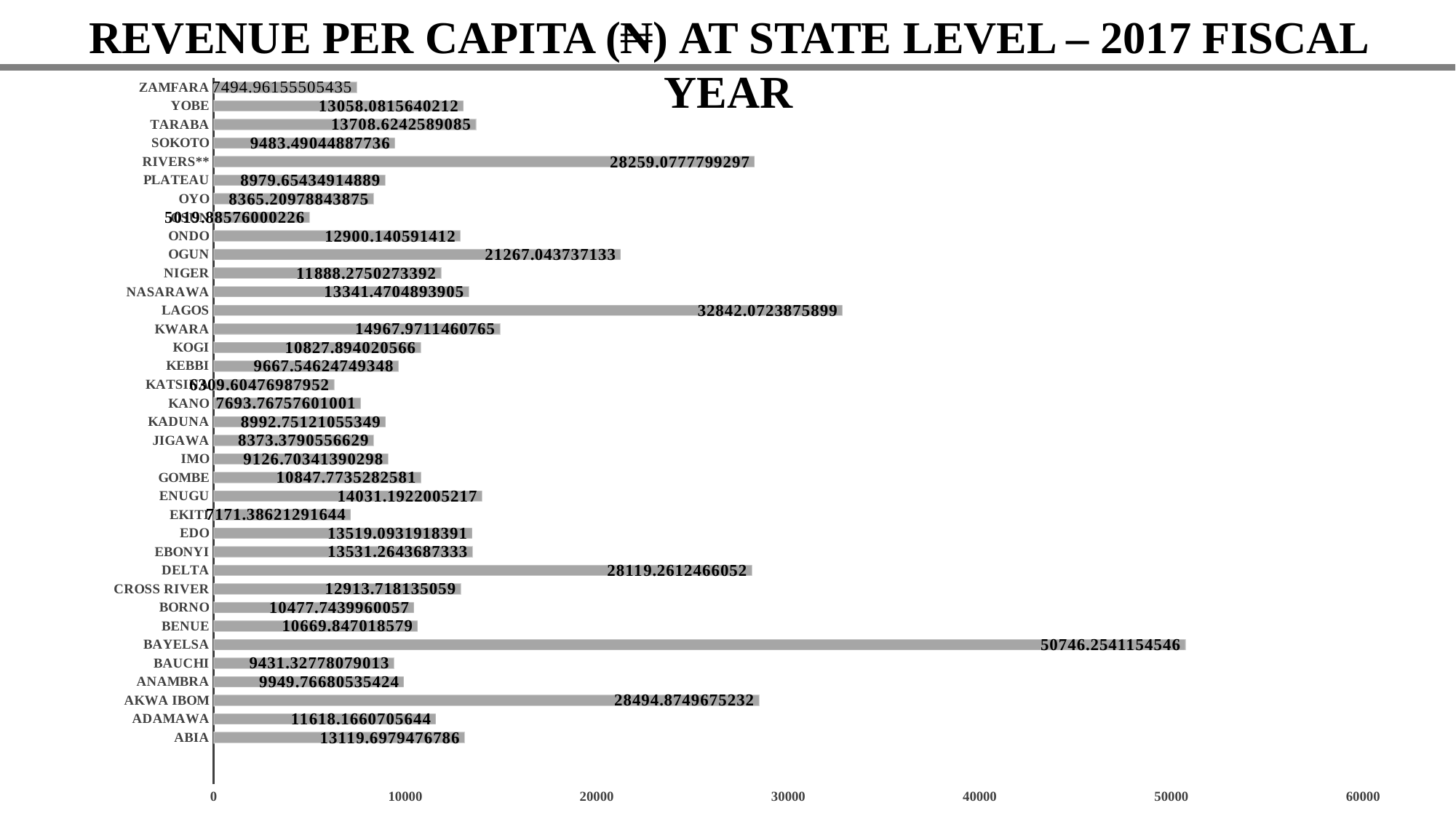
What type of chart is shown on the slide? Bar chart What is the revenue per capita for BAYELSA? 50746.2541154546 Which is larger, the revenue per capita for OGUN or for KWARA? OGUN Is the revenue per capita for OGUN greater or less than 20000? greater What is the revenue per capita for AKWA IBOM? 28494.8749675232 What is the difference between the revenue per capita of BAYELSA and LAGOS? 17904.1817278647 Which state has the highest revenue per capita? BAYELSA What is the title of the chart? REVENUE PER CAPITA (₦) AT STATE LEVEL – 2017 FISCAL YEAR Which is larger, the revenue per capita for LAGOS or for RIVERS**? LAGOS What is the revenue per capita for LAGOS? 32842.0723875899 Is the revenue per capita for KANO greater or less than 10000? less What is the revenue per capita for KANO? 7693.76757601001